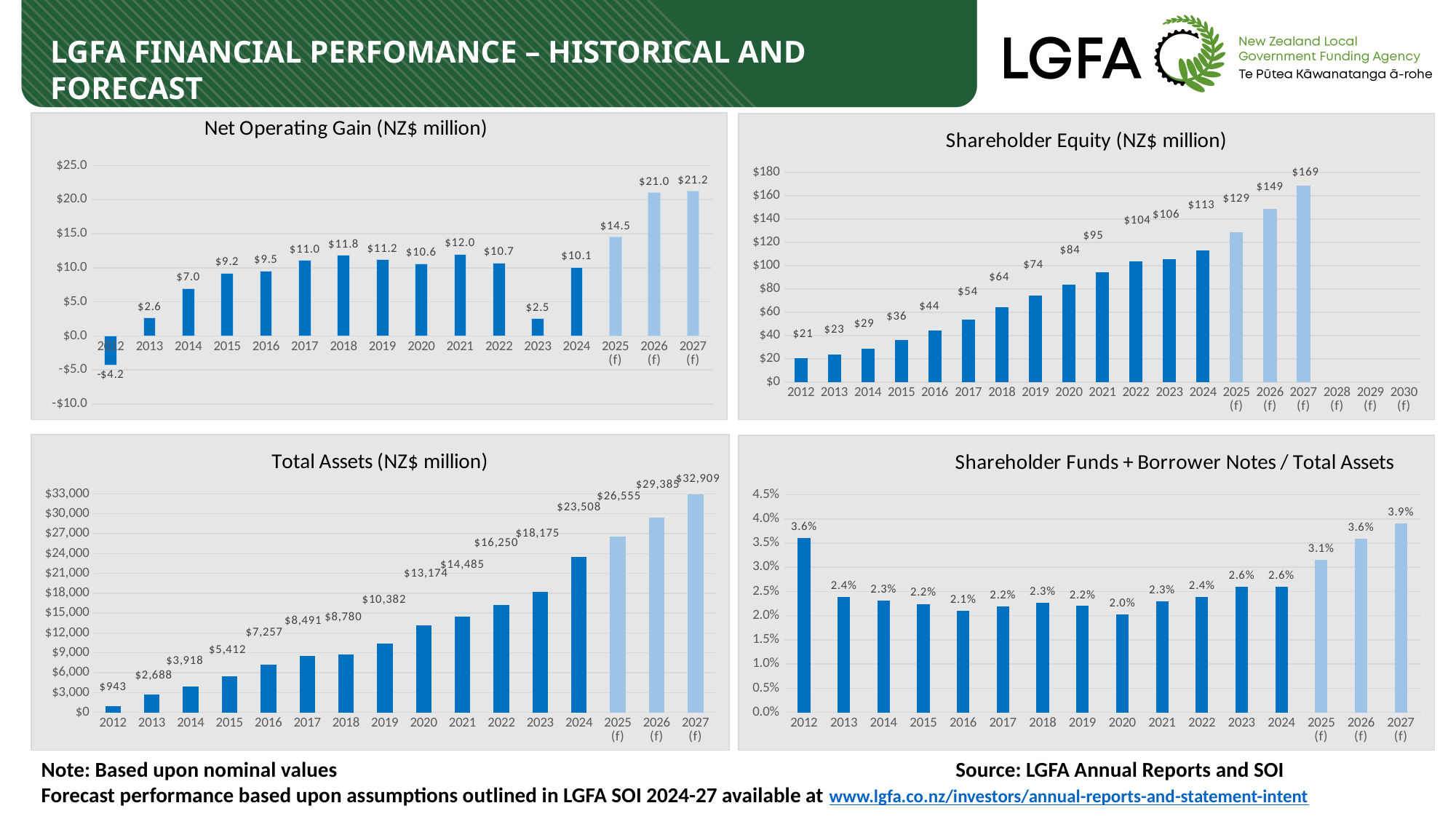
What kind of chart is the Total Assets chart? bar chart In the Shareholder Equity chart, what is the value for 2021? $95 In the Shareholder Equity chart, what is the difference between the 2027 (f) and 2012 values? $148 In the Shareholder Equity chart, do the values rise or fall from 2012 to 2027 (f)? rise In the Shareholder Funds + Borrower Notes / Total Assets chart, which is larger, the value for 2012 or the value for 2025 (f)? 2012 In the Shareholder Funds + Borrower Notes / Total Assets chart, what is the value for 2020? 2.0% In the Total Assets chart, which year has the lowest value? 2012 In the Total Assets chart, how many bars are plotted? 16 In the Net Operating Gain chart, what is the difference between the 2026 (f) and 2024 values? $10.9 In the Net Operating Gain chart, what is the value for 2012? -$4.2 In the Net Operating Gain chart, which year has the highest value? 2027 (f) In the Total Assets chart, what is the value for 2020? $13,174